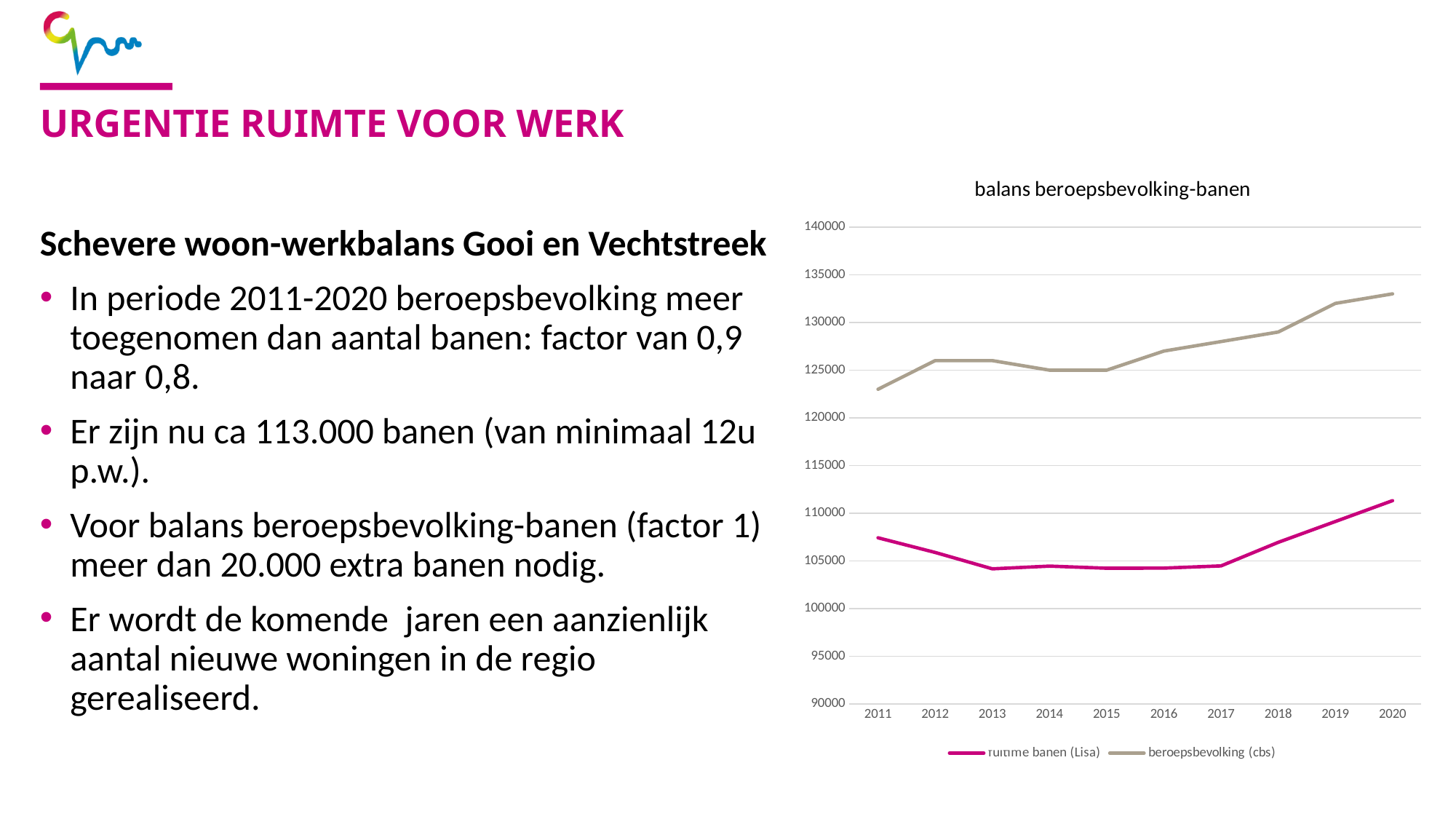
Is the value for beroepsbevolking (cbs) in 2020 greater or less than 130000? greater Is the value of the pink banen (Lisa) line in 2020 greater or less than 110000? greater In 2020, which series has the higher value: beroepsbevolking (cbs) or banen (Lisa)? beroepsbevolking (cbs) How many years are shown on the x axis of the chart? 10 What kind of chart is shown on the slide? line chart In which year does beroepsbevolking (cbs) reach its highest value? 2020 Is the value of the pink banen (Lisa) line in 2013 greater or less than 105000? less Which series in the chart is drawn with the grey line? beroepsbevolking (cbs) What is the title of the chart? balans beroepsbevolking-banen How many series does the chart's legend list? 2 Does the beroepsbevolking (cbs) line rise or fall from 2017 to 2020? rise